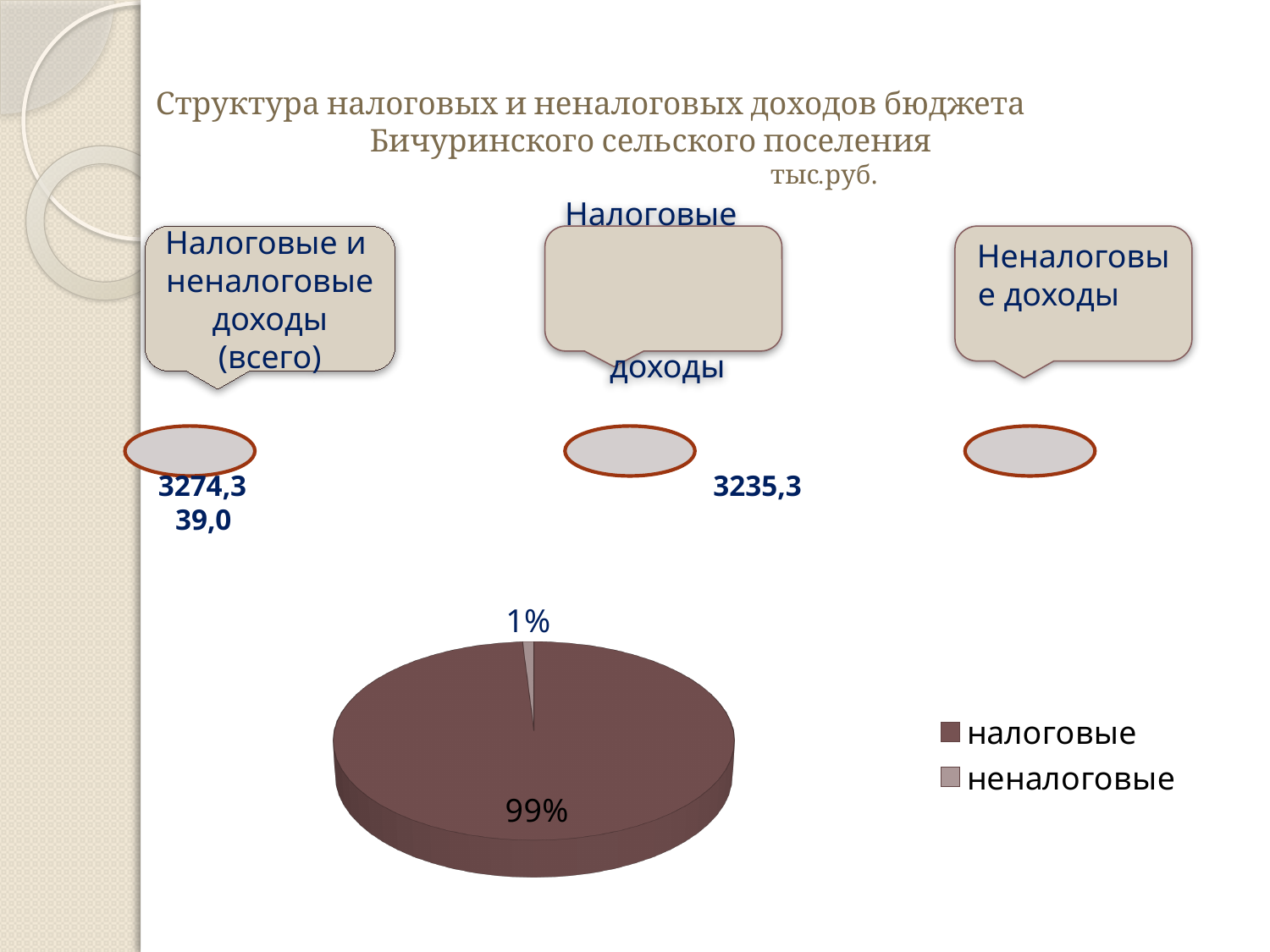
What share of the pie does the неналоговые slice represent? 1% What kind of chart is shown on the slide? pie chart How many entries does the legend of the pie chart list? 2 Which is larger in the pie chart, налоговые or неналоговые? налоговые Which slice of the pie chart is the largest? налоговые How many slices does the pie chart have? 2 Which slice of the pie chart is the smallest? неналоговые What colour is the налоговые slice in the pie chart? dark brown What share of the pie does the налоговые slice represent? 99% Which legend entry is shown in light grey? неналоговые By how many percentage points does the налоговые share exceed the неналоговые share? 98